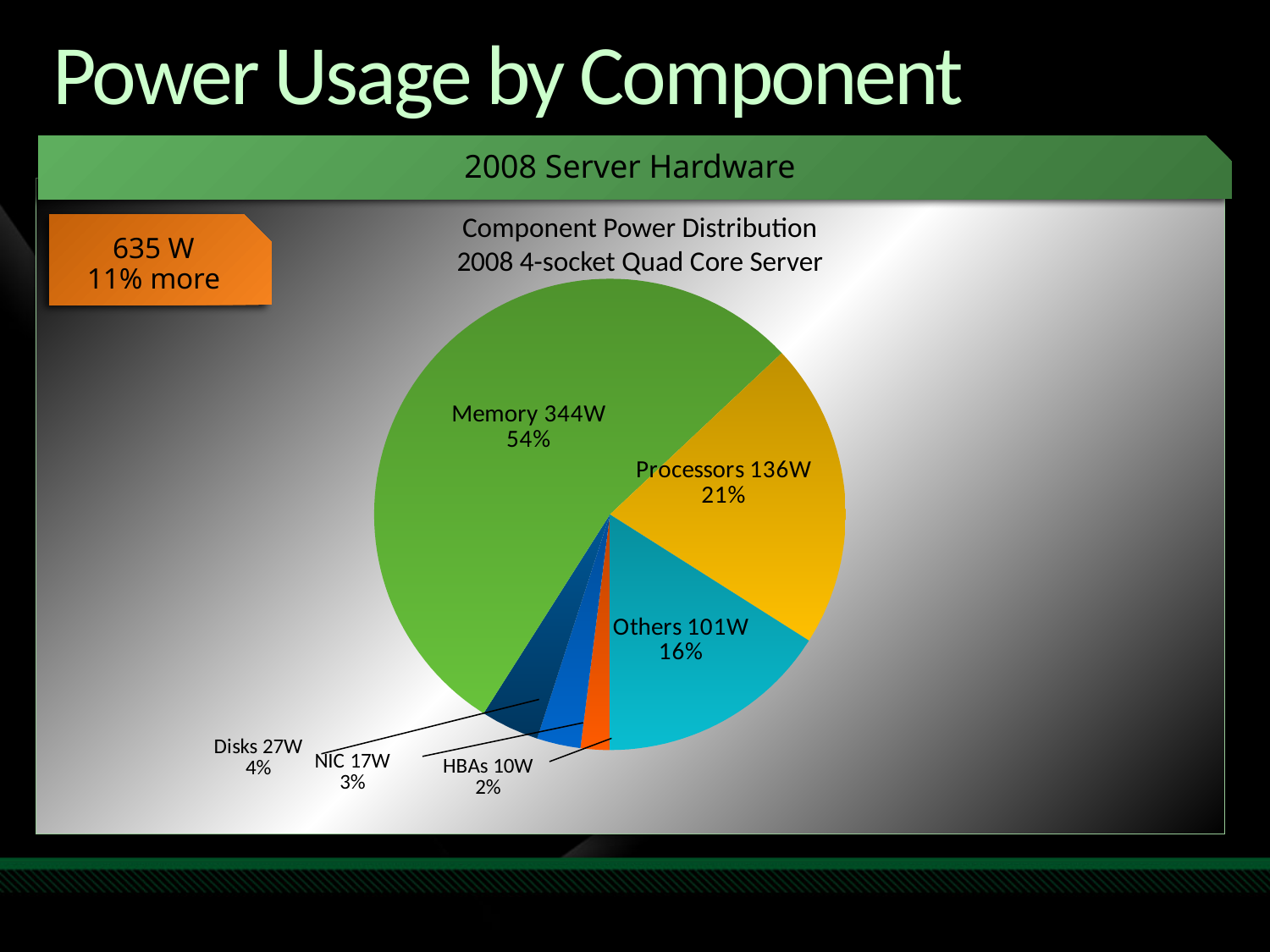
Which component uses the least power? HBAs How many components are shown in the pie chart? 6 What is the difference in power usage between Memory and Processors? 208W What percentage share does Memory have? 54% What is the difference in power usage between Others and Disks? 74W Which component uses the most power? Memory What is the power usage of Processors? 136W What percentage share does Others have? 16% What is the title of the chart? Component Power Distribution 2008 4-socket Quad Core Server Which uses more power, Disks or NIC? Disks What is the power usage of Memory? 344W What type of chart is shown on the slide? Pie chart